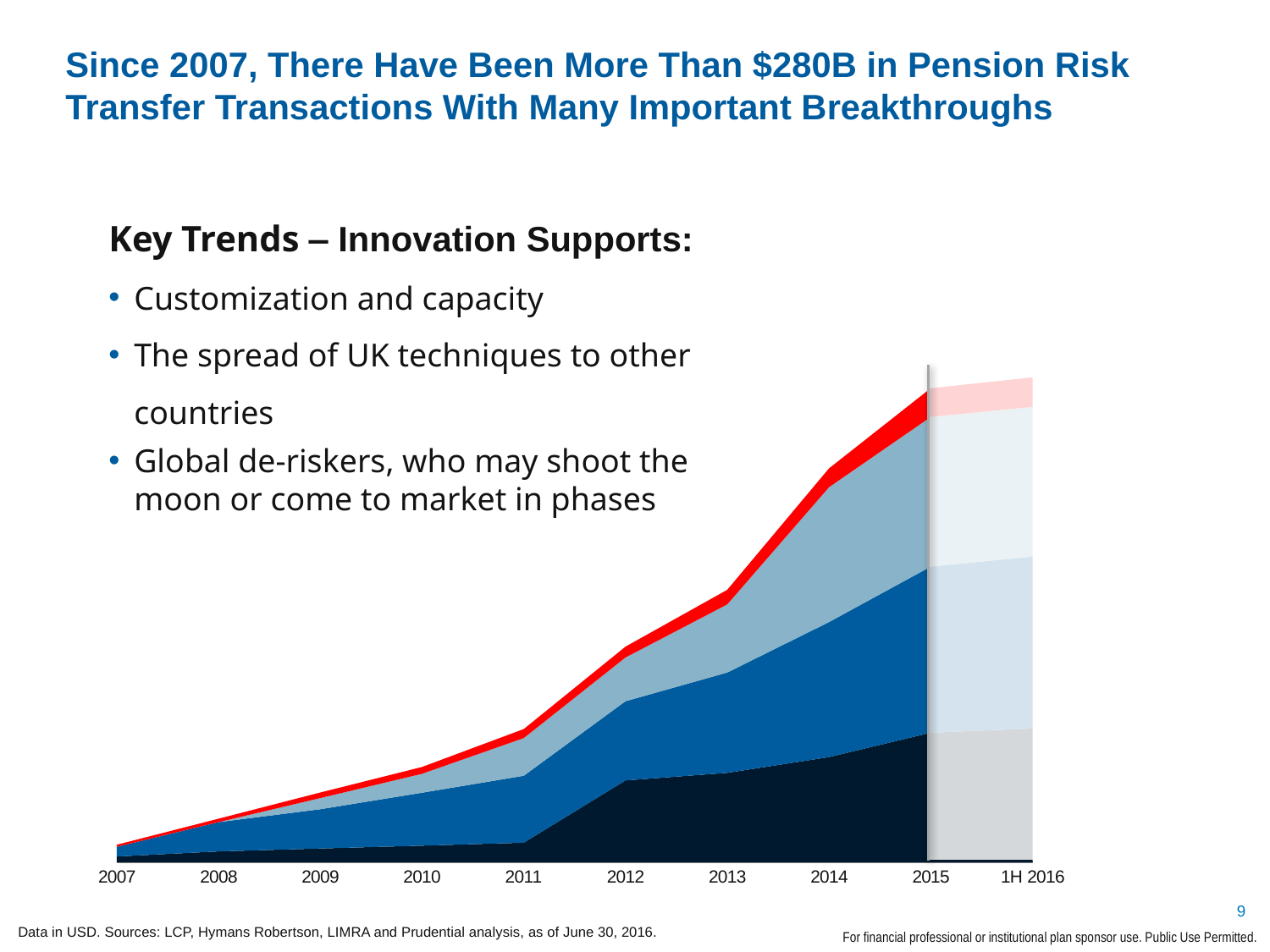
Is the total value for 2014 larger or smaller than the total value for 2013? larger What is the last period labelled on the x axis of the chart? 1H 2016 What kind of chart is shown on the slide? stacked area chart Do the total values in the chart generally rise or fall from 2007 to 2015? rise Which full year from 2007 to 2015 has the highest total value in the chart? 2015 Between 2011 and 2012, does the total value in the chart rise or fall? rise Which year has the lowest total value in the chart? 2007 What is the first period labelled on the x axis of the chart? 2007 Is the total value for 2012 larger or smaller than the total value for 2009? larger Is the total value for 2010 larger or smaller than the total value for 2015? smaller How many time periods are labelled on the x axis of the chart? 10